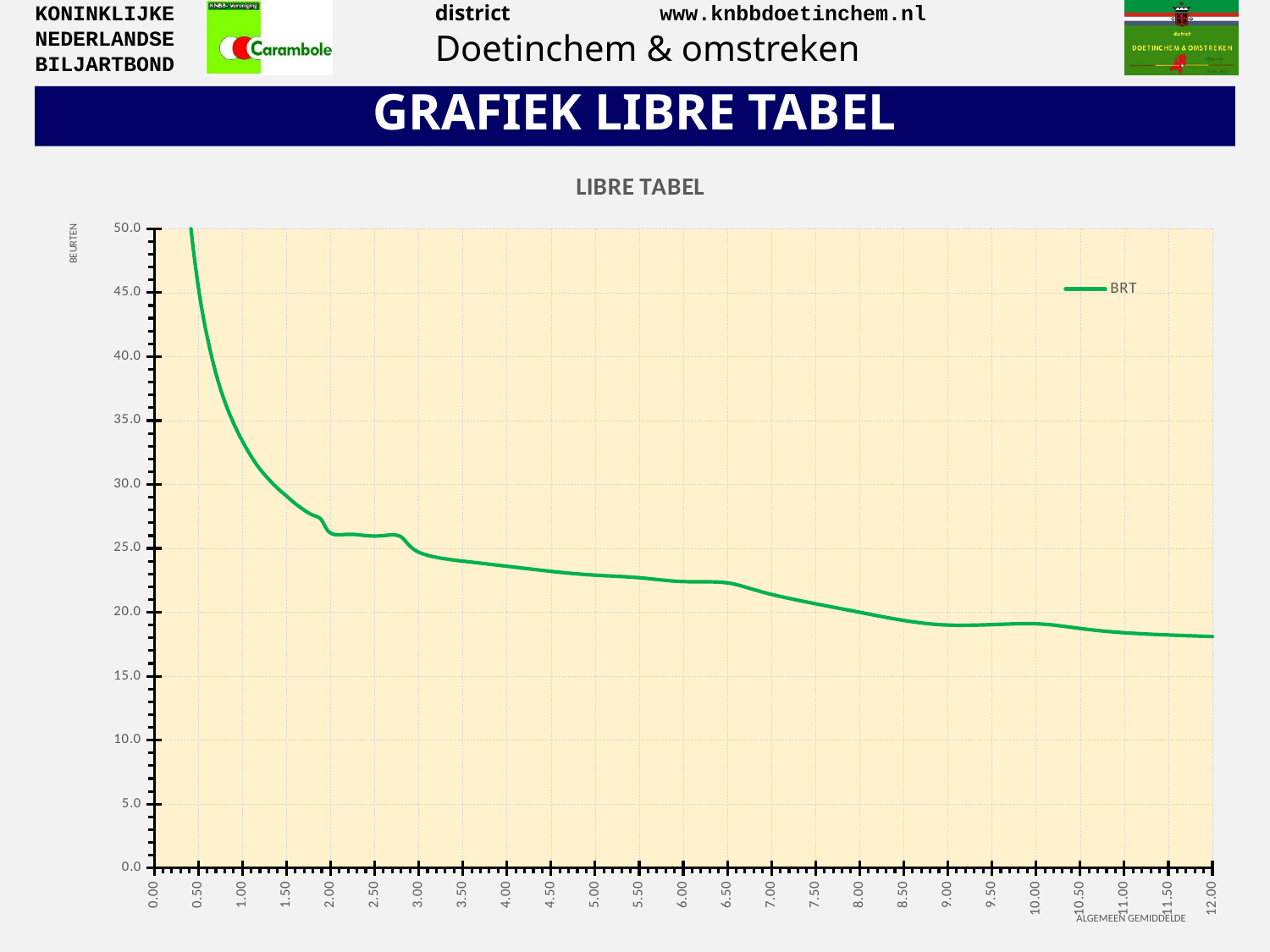
Is the BRT value at an ALGEMEEN GEMIDDELDE of 6.00 greater or less than 20.0? greater Is the BRT value at an ALGEMEEN GEMIDDELDE of 4.00 greater or less than 25.0? less Is the BRT value at an ALGEMEEN GEMIDDELDE of 6.00 greater or less than 25.0? less Do the BRT values rise or fall as the x axis (ALGEMEEN GEMIDDELDE) increases? fall What is the title of the chart? LIBRE TABEL What kind of chart is shown on the slide? line chart What is the name of the series shown in the legend? BRT How many series does the legend list? 1 Which is larger, the BRT value at an ALGEMEEN GEMIDDELDE of 1.00 or at 9.00? 1.00